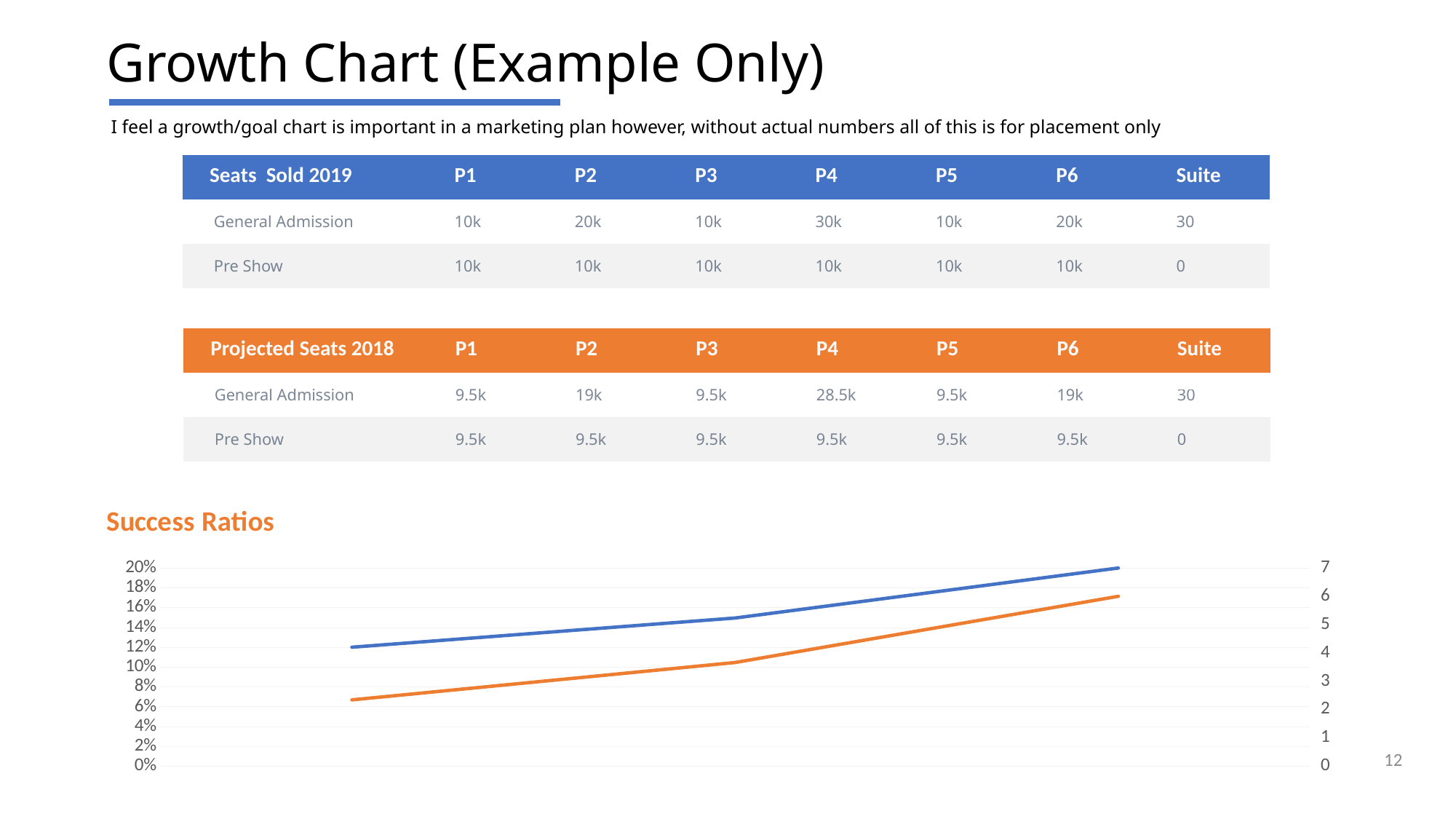
In the Success Ratios chart, is the rightmost value of the blue line greater or less than 18% on the left axis? greater In the Success Ratios chart, does the blue line rise or fall from left to right? rise What kind of chart is shown under the heading "Success Ratios"? line chart In the Success Ratios chart, does the orange line rise or fall from left to right? rise In the Success Ratios chart, which line is higher at the rightmost point, the blue line or the orange line? the blue line How many lines are plotted in the Success Ratios chart? 2 In the Success Ratios chart, is the leftmost value of the orange line greater or less than 8% on the left axis? less In the Success Ratios chart, is the leftmost value of the blue line greater or less than 10% on the left axis? greater What is the highest tick label on the left vertical axis of the Success Ratios chart? 20% What is the highest tick label on the right vertical axis of the Success Ratios chart? 7 How many data points does each line in the Success Ratios chart have? 3